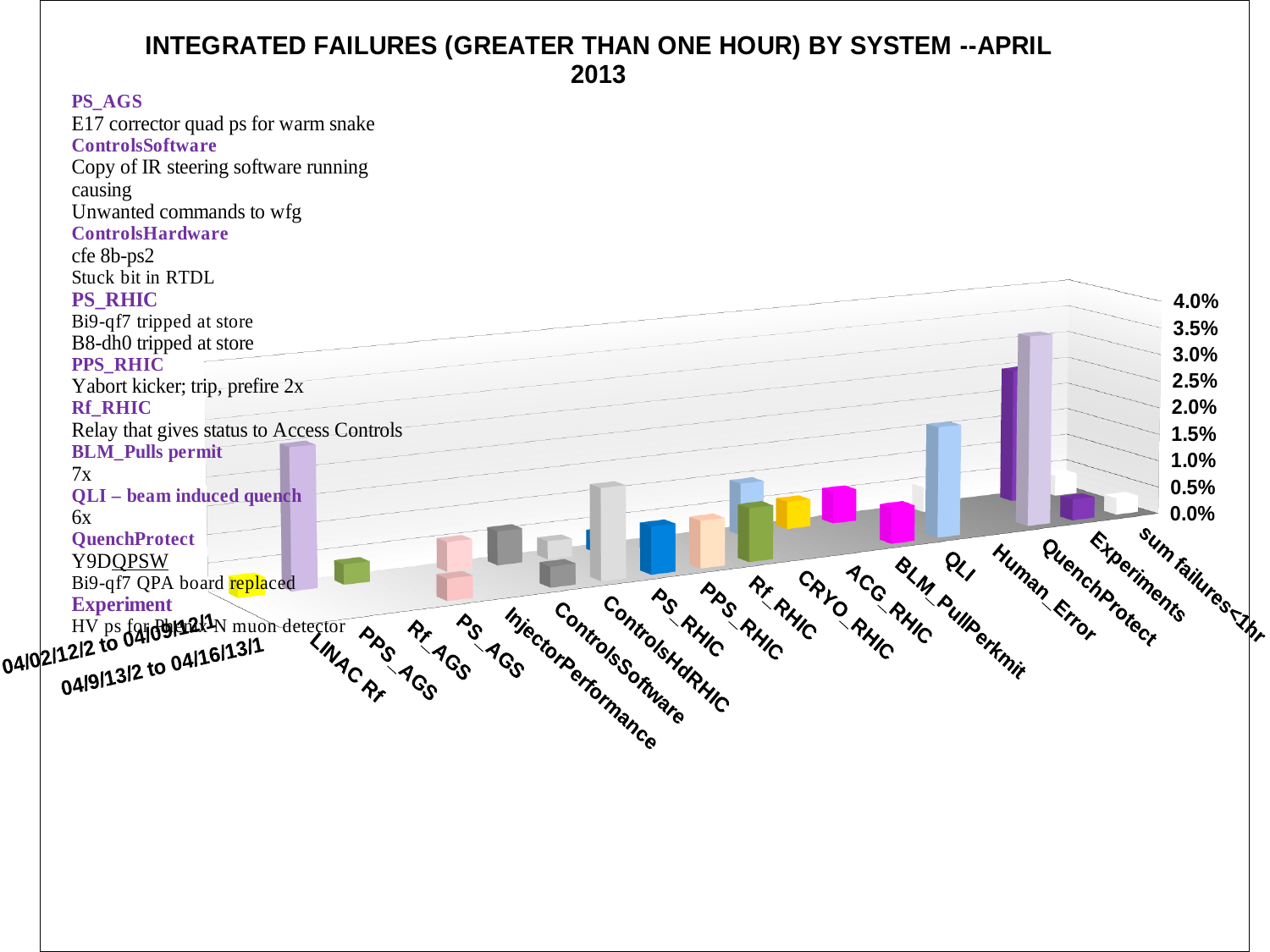
What kind of chart is shown on the slide? bar chart What is the highest value shown on the chart's vertical axis? 4.0% Which category is the first one listed on the x axis of the chart? LINAC Rf Which category has the tallest bar in the chart? QuenchProtect Which category is the last one listed on the x axis of the chart? sum failures<1hr How many system categories are shown along the x axis of the chart? 18 What is the title of the chart? INTEGRATED FAILURES (GREATER THAN ONE HOUR) BY SYSTEM --APRIL 2013